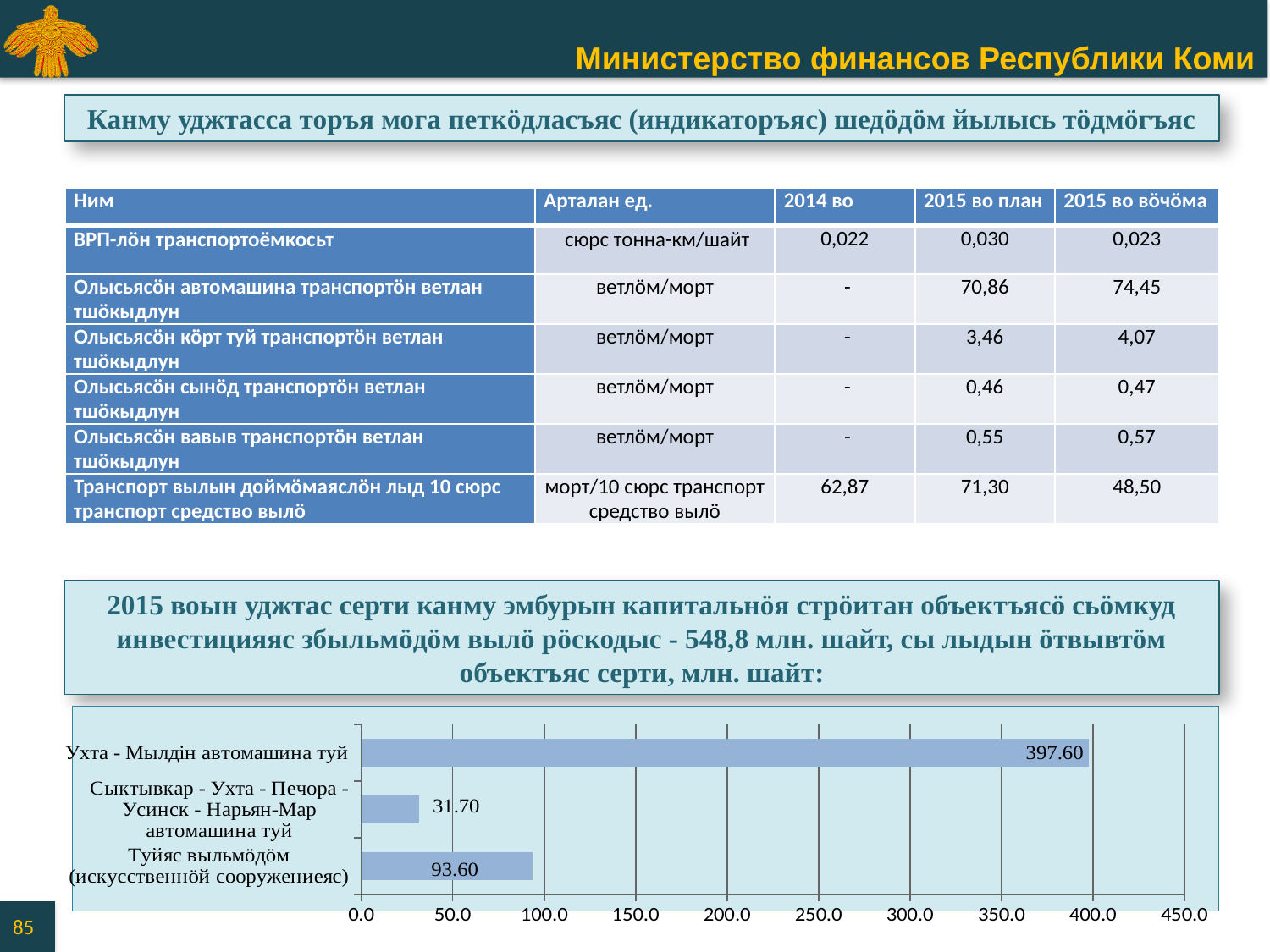
How many categories are plotted in the bar chart? 3 What is the difference between the values for Туйяс выльмöдöм (искусственнöй сооружениеяс) and Сыктывкар - Ухта - Печора - Усинск - Нарьян-Мар автомашина туй in the bar chart? 61.90 What type of chart is shown at the bottom of the slide? bar chart What is the maximum value shown on the horizontal axis of the bar chart? 450.0 What is the value for Сыктывкар - Ухта - Печора - Усинск - Нарьян-Мар автомашина туй in the bar chart? 31.70 Which category has the highest value in the bar chart? Ухта - Мылдін автомашина туй What is the difference between the values for Ухта - Мылдін автомашина туй and Туйяс выльмöдöм (искусственнöй сооружениеяс) in the bar chart? 304.00 What is the value for Ухта - Мылдін автомашина туй in the bar chart? 397.60 Which category has the lowest value in the bar chart? Сыктывкар - Ухта - Печора - Усинск - Нарьян-Мар автомашина туй Is the value for Ухта - Мылдін автомашина туй in the bar chart greater or less than 350.0? greater In the bar chart, which is larger: the value for Туйяс выльмöдöм (искусственнöй сооружениеяс) or the value for Сыктывкар - Ухта - Печора - Усинск - Нарьян-Мар автомашина туй? Туйяс выльмöдöм (искусственнöй сооружениеяс) What is the value for Туйяс выльмöдöм (искусственнöй сооружениеяс) in the bar chart? 93.60